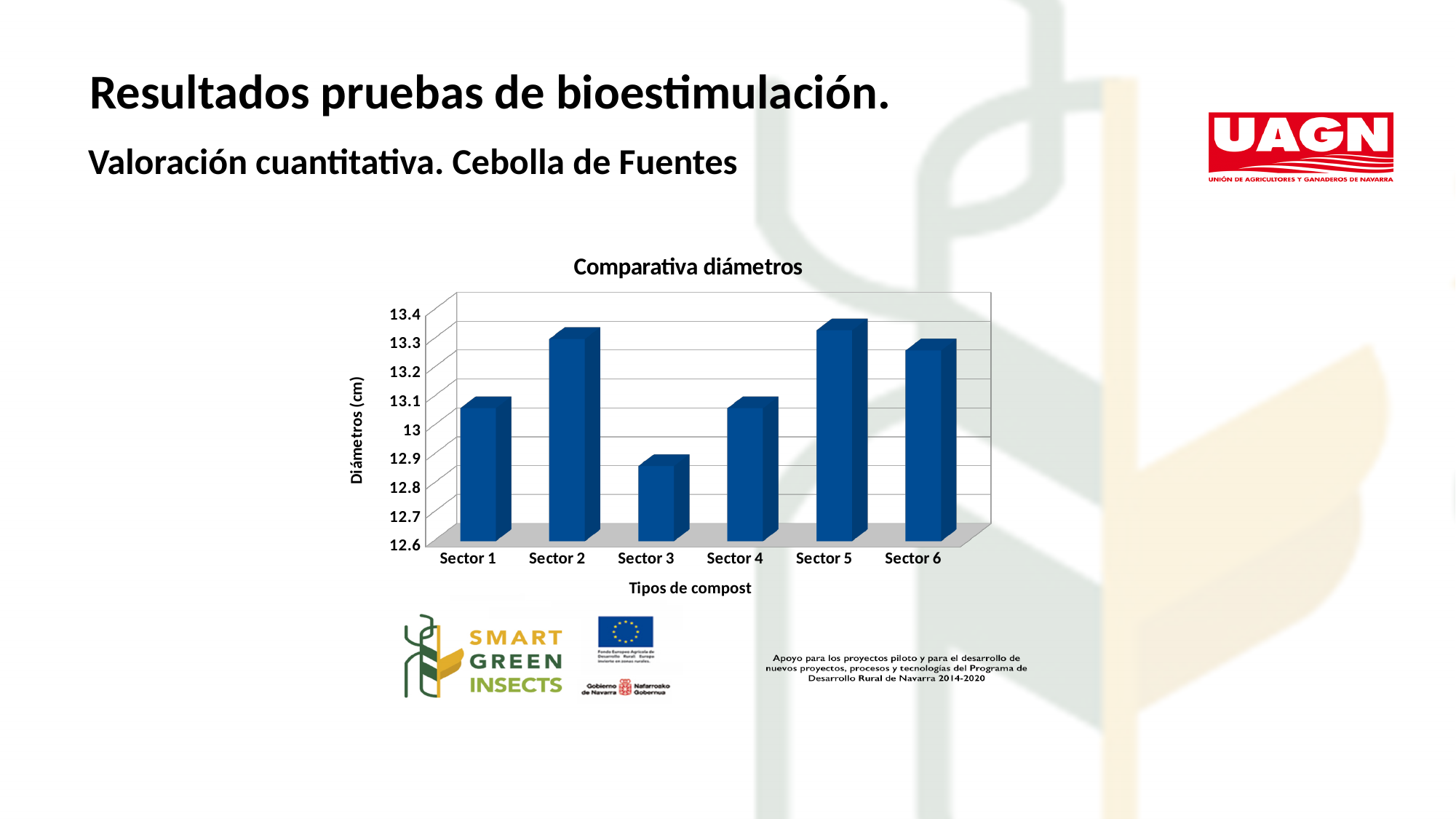
Which is larger, the value for Sector 2 or the value for Sector 3? Sector 2 Is the value for Sector 6 greater or less than 13.2? greater What kind of chart is shown on the slide? Bar chart Is the value for Sector 2 greater or less than 13.2? greater How many sectors are plotted in the chart? 6 What is the title of the chart? Comparativa diámetros Is the value for Sector 1 greater or less than 13? greater What is the label of the vertical axis? Diámetros (cm) Which sector has the lowest diameter? Sector 3 Which is larger, the value for Sector 6 or the value for Sector 1? Sector 6